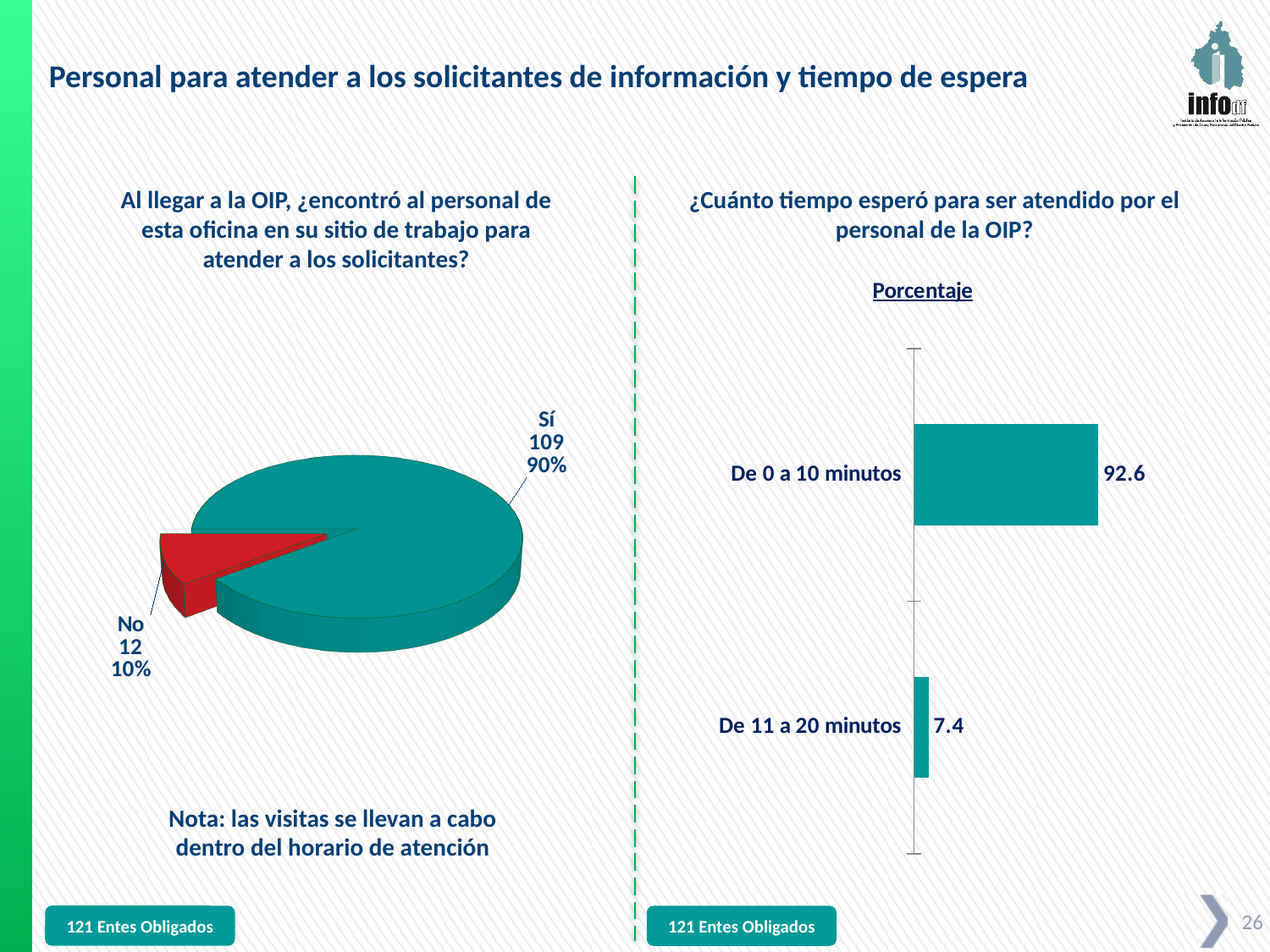
In the pie chart on the left, how many categories are shown? 2 In the bar chart on the right, what is the value for "De 11 a 20 minutos"? 7.4 In the pie chart on the left, how many respondents answered "Sí"? 109 In the pie chart on the left, what is the difference between the counts for "Sí" and "No"? 97 In the pie chart on the left, what percentage share does the "Sí" slice represent? 90% What kind of chart is shown on the right side of the slide? Bar chart In the pie chart on the left, what percentage share does the "No" slice represent? 10% In the bar chart on the right, what is the value for "De 0 a 10 minutos"? 92.6 In the pie chart on the left, what colour is the "No" slice? Red In the bar chart on the right, what is the difference between the values for "De 0 a 10 minutos" and "De 11 a 20 minutos"? 85.2 In the bar chart on the right, which category has the highest value? De 0 a 10 minutos In the pie chart on the left, which category has the smallest slice? No